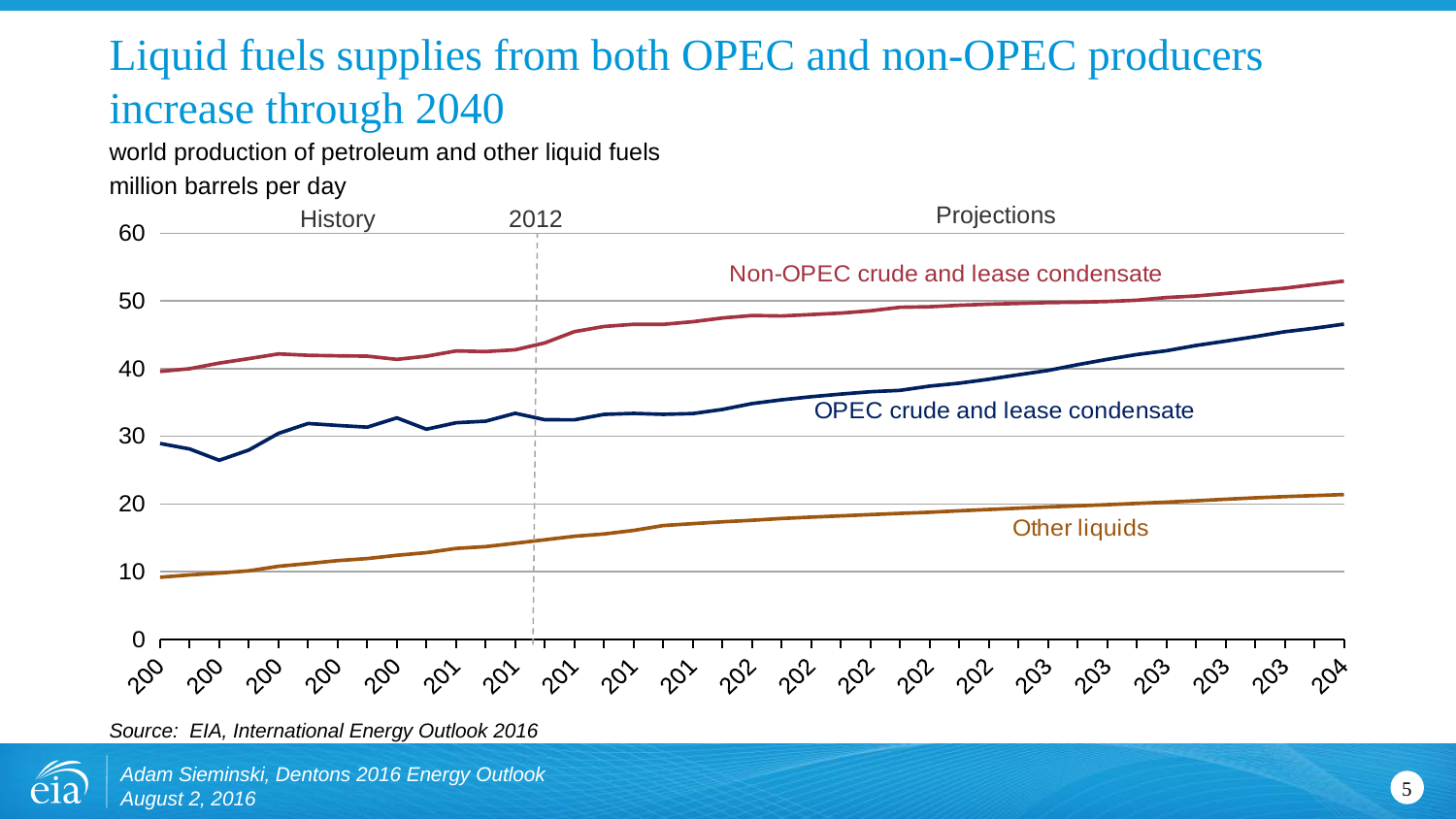
What unit is the chart measured in, according to the subtitle? million barrels per day Is the value for Non-OPEC crude and lease condensate in 2012 greater or less than 40? greater In 2012, which is larger: Non-OPEC crude and lease condensate or OPEC crude and lease condensate? Non-OPEC crude and lease condensate How many series are plotted on the chart? 3 At the end of the projection period, is the value for OPEC crude and lease condensate greater or less than 50? less Is the value for OPEC crude and lease condensate in 2012 greater or less than 30? greater Do the values for Other liquids rise or fall over the projection period? rise What kind of chart is shown on the slide? line chart What year does the dashed vertical line separating History from Projections mark? 2012 Which series has the highest values across the projection period? Non-OPEC crude and lease condensate Which series has the lowest values throughout the chart? Other liquids